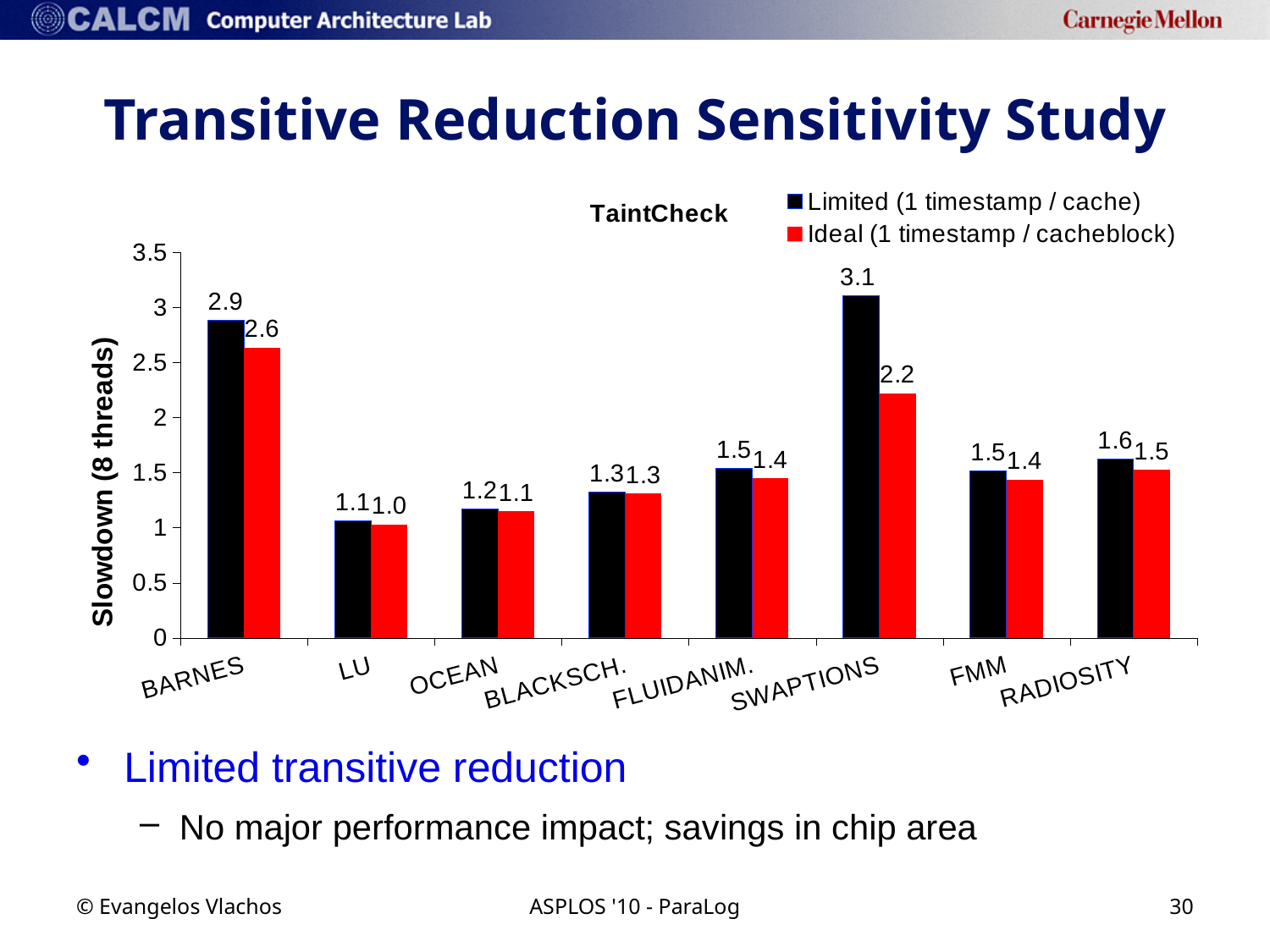
What is the difference between the Limited and Ideal slowdowns for SWAPTIONS? 0.9 What is the Ideal (1 timestamp / cacheblock) slowdown for BARNES? 2.6 Which benchmark has the lowest Ideal (1 timestamp / cacheblock) slowdown? LU Is the Limited (1 timestamp / cache) slowdown for BARNES greater or less than 2.5? greater How many series does the chart legend list? 2 How many benchmarks are shown on the x axis of the chart? 8 Which is larger for BARNES: the Limited (1 timestamp / cache) slowdown or the Ideal (1 timestamp / cacheblock) slowdown? Limited (1 timestamp / cache) What kind of chart is shown on the slide? bar chart What is the Ideal (1 timestamp / cacheblock) slowdown for LU? 1.0 What is the Limited (1 timestamp / cache) slowdown for SWAPTIONS? 3.1 What is the label of the y axis of the chart? Slowdown (8 threads) Which benchmark has the highest Limited (1 timestamp / cache) slowdown? SWAPTIONS